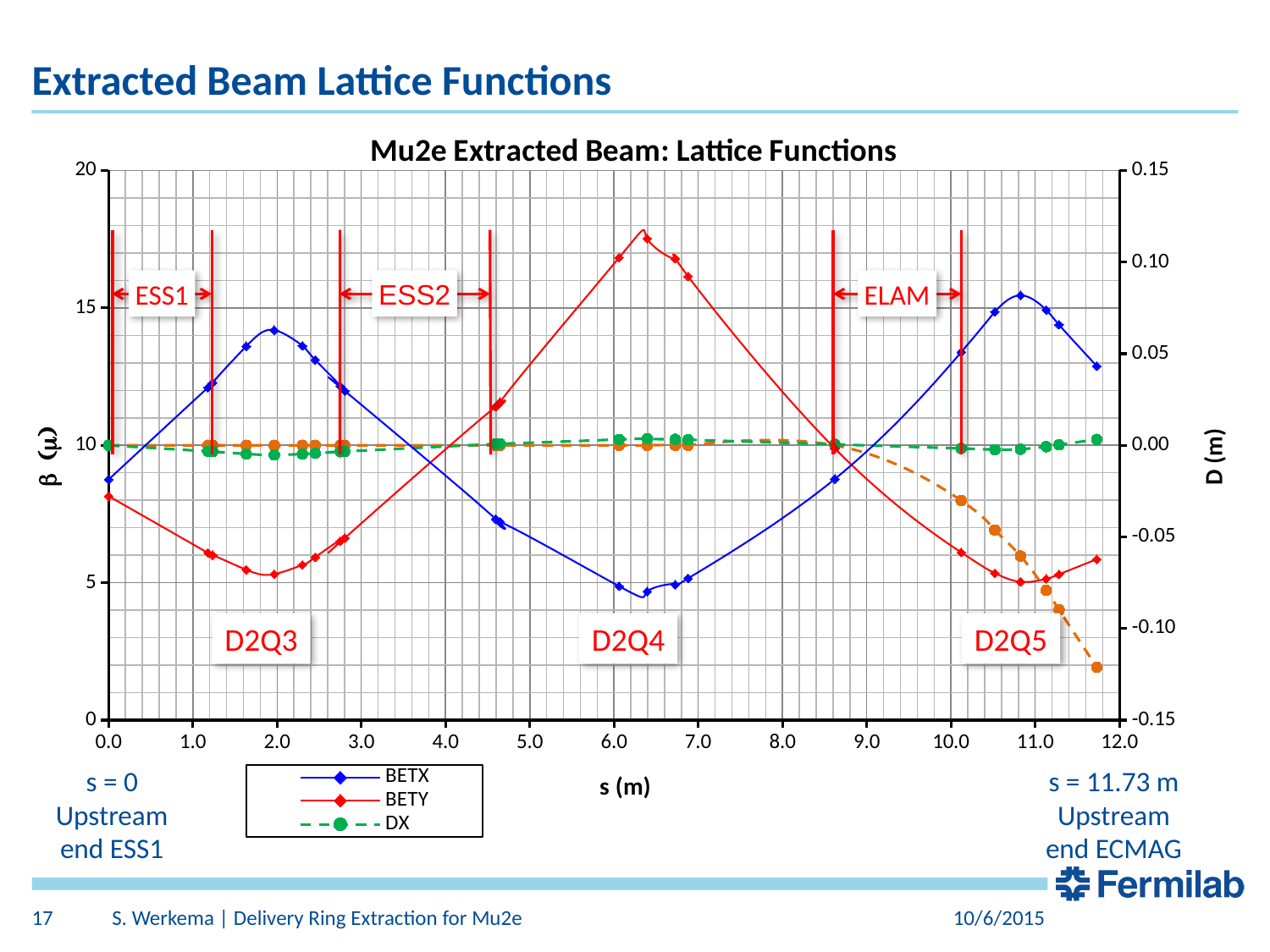
At s = 2.0 m, which series has the larger value, BETX or BETY? BETX What kind of chart is shown on the slide? line chart Is the minimum value of BETY near s = 11.0 m greater or less than 10? less Is the peak value of BETX near s = 2.0 m greater or less than 15? less Which series reaches the highest β value anywhere on the chart? BETY What is the title of the chart? Mu2e Extracted Beam: Lattice Functions At s = 6.3 m, which series has the larger value, BETX or BETY? BETY What are the three series named in the legend? BETX, BETY, DX Is the peak value of BETY near s = 6.3 m greater or less than 15? greater How many series does the chart legend list? 3 Between s = 9.0 m and s = 10.8 m, does BETX rise or fall? rise